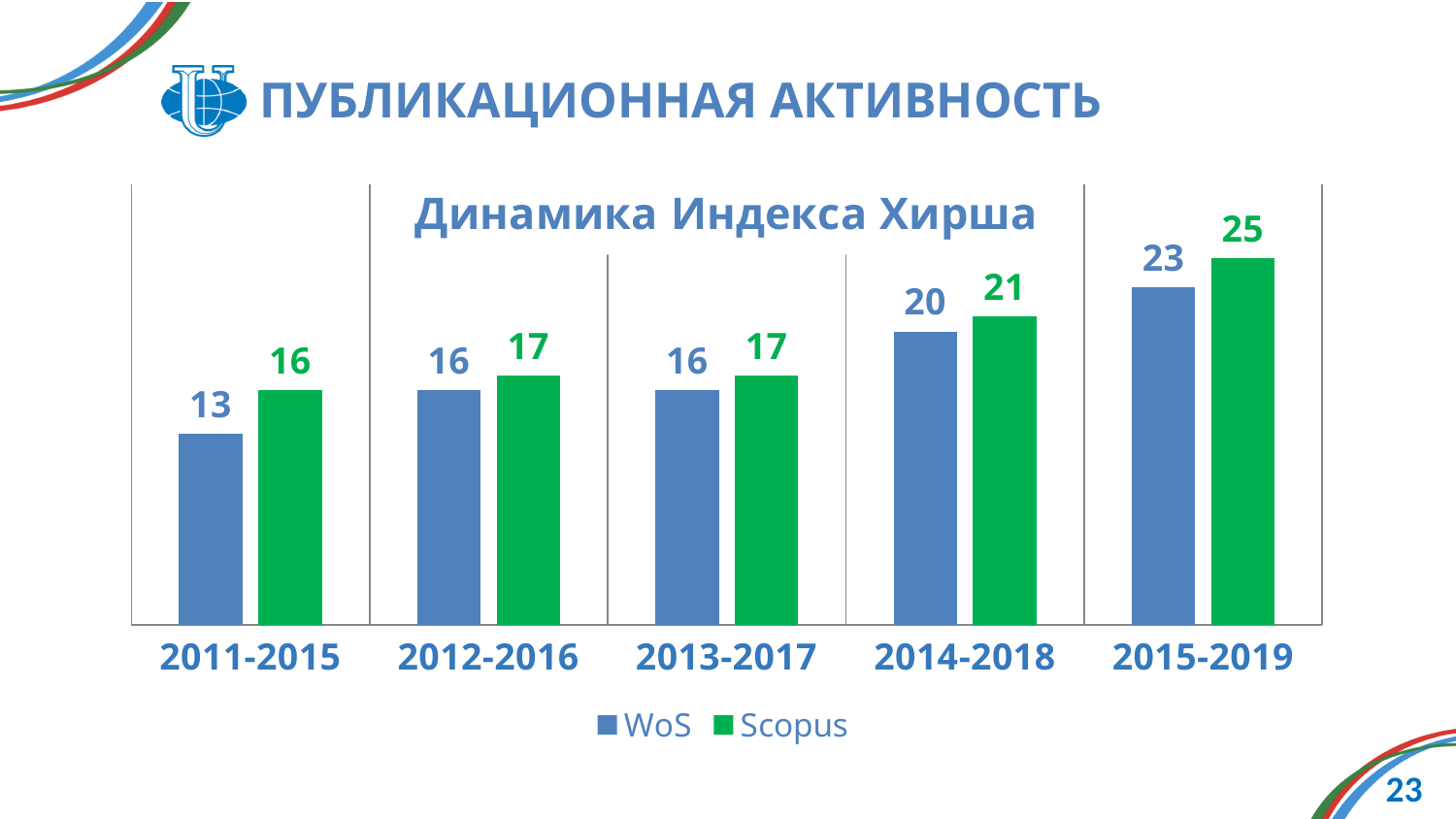
What is the Scopus value for 2015-2019? 25 How many periods are shown on the x axis? 5 What is the WoS value for 2011-2015? 13 What kind of chart is shown? Bar chart Which period has the highest WoS value? 2015-2019 What is the difference between the WoS values for 2015-2019 and 2014-2018? 3 Do the WoS values rise or fall from 2011-2015 to 2015-2019? Rise Which is larger for 2014-2018, the WoS value or the Scopus value? Scopus How many series does the legend list? 2 What is the Scopus value for 2014-2018? 21 Which period has the lowest Scopus value? 2011-2015 What is the difference between the Scopus and WoS values for 2011-2015? 3